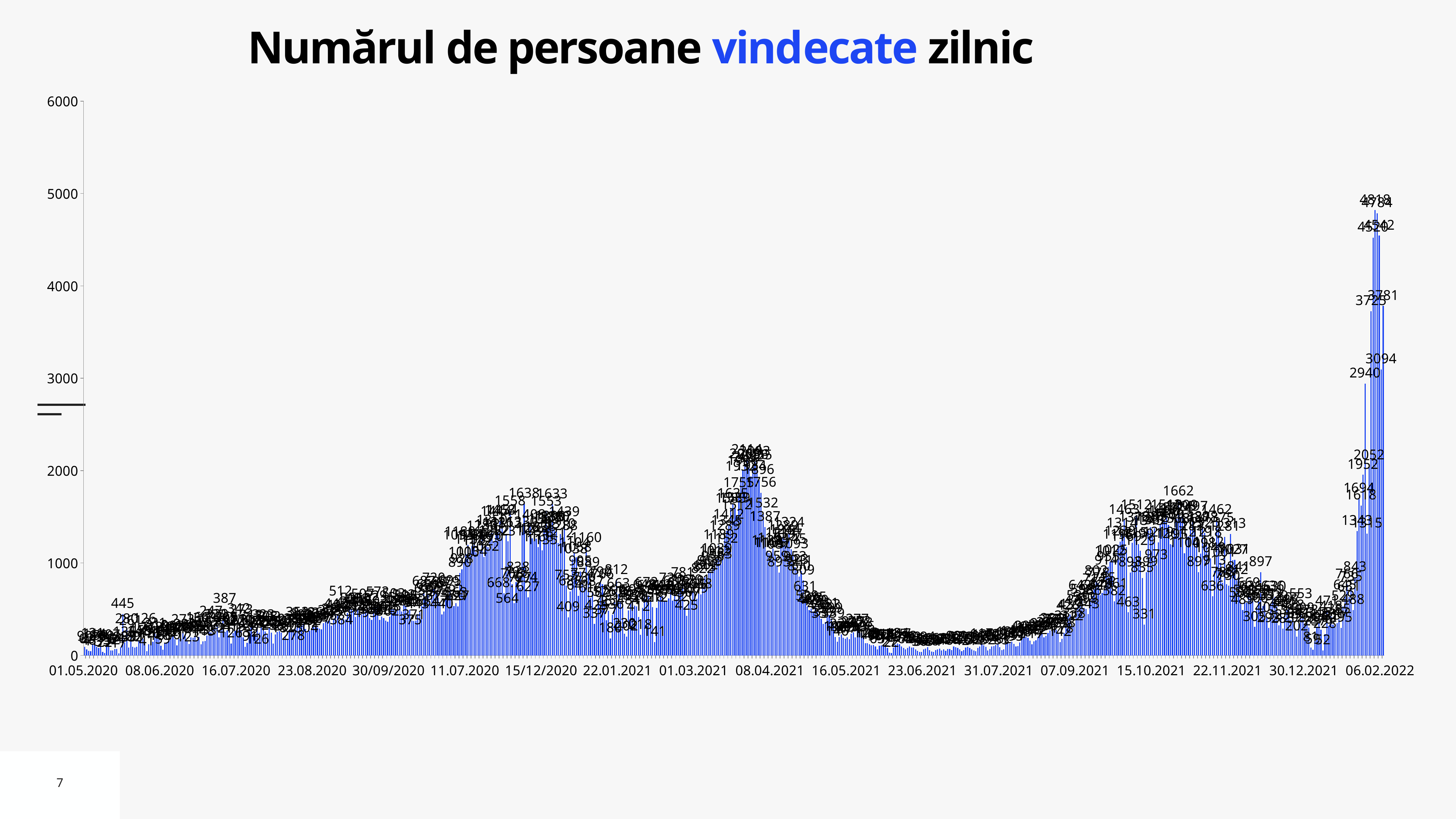
What is the last date label on the horizontal axis? 06.02.2022 Which peak is higher: the one around 08.04.2021 or the one around 15.12.2020? 08.04.2021 Do the values generally rise or fall between 16.05.2021 and 23.06.2021? fall What is the title of the chart? Numărul de persoane vindecate zilnic Are the bars around 23.06.2021 greater or less than 1000? less Do the values generally rise or fall between 30.12.2021 and 06.02.2022? rise Around which date label on the horizontal axis do the tallest bars of the whole chart appear? 06.02.2022 What is the first date label on the horizontal axis? 01.05.2020 What is the highest value shown on the vertical axis? 6000 Are the highest bars around 08.04.2021 greater or less than 2000? greater Is the tallest bar in the chart greater or less than 4000? greater What kind of chart is shown on the slide? bar chart